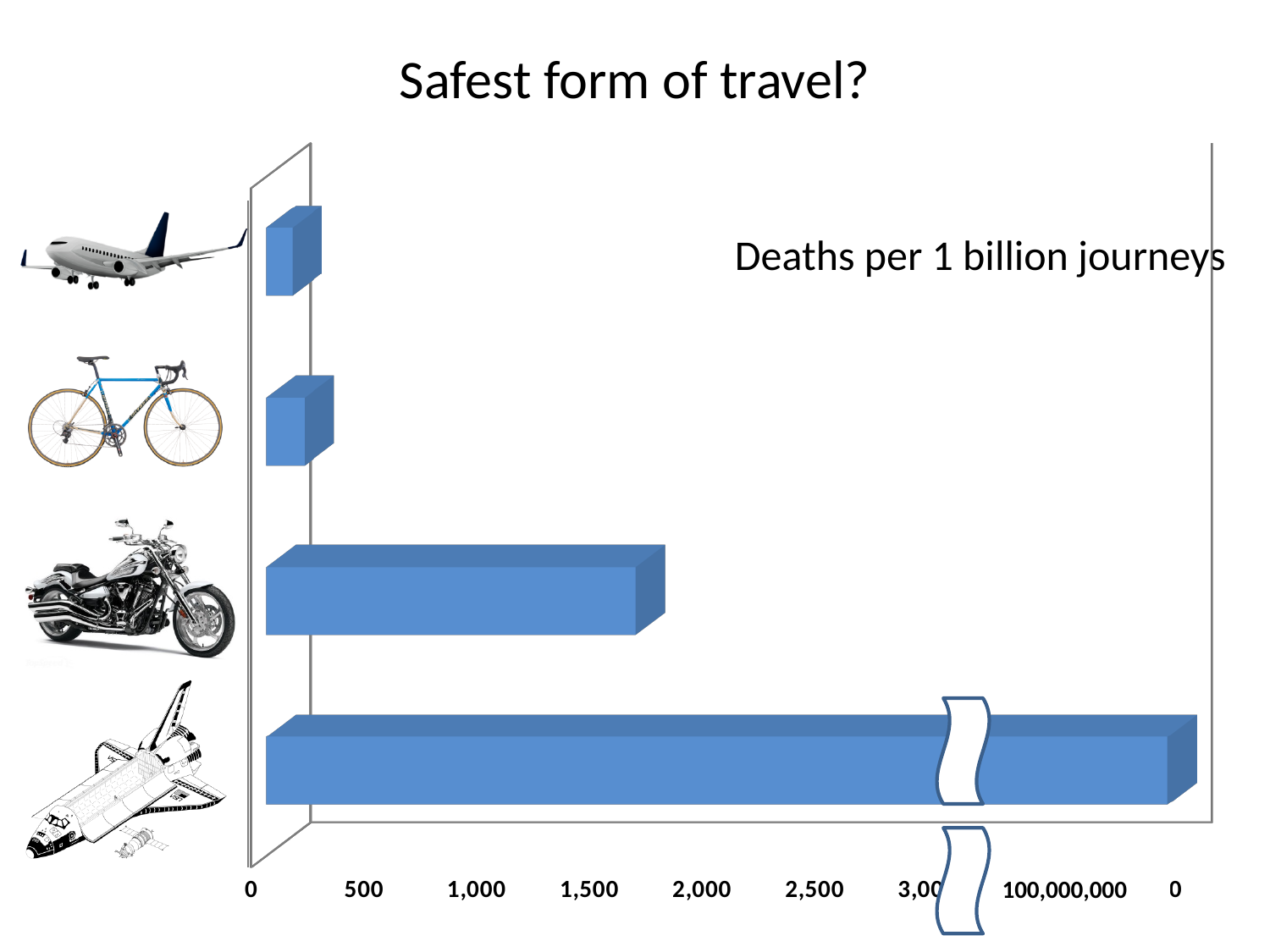
Is the value for the motorcycle bar greater or less than 1,000? greater What kind of chart is shown on the slide? bar chart Is the value for the motorcycle bar greater or less than 2,000? less Which has the larger value, the motorcycle bar or the bicycle bar? motorcycle What is the title of the slide containing the chart? Safest form of travel? What quantity does the chart say it measures, according to the text on the chart? Deaths per 1 billion journeys Which form of travel has the longest bar in the chart? space shuttle Is the value for the airplane bar greater or less than 500? less How many bars are plotted in the chart? 4